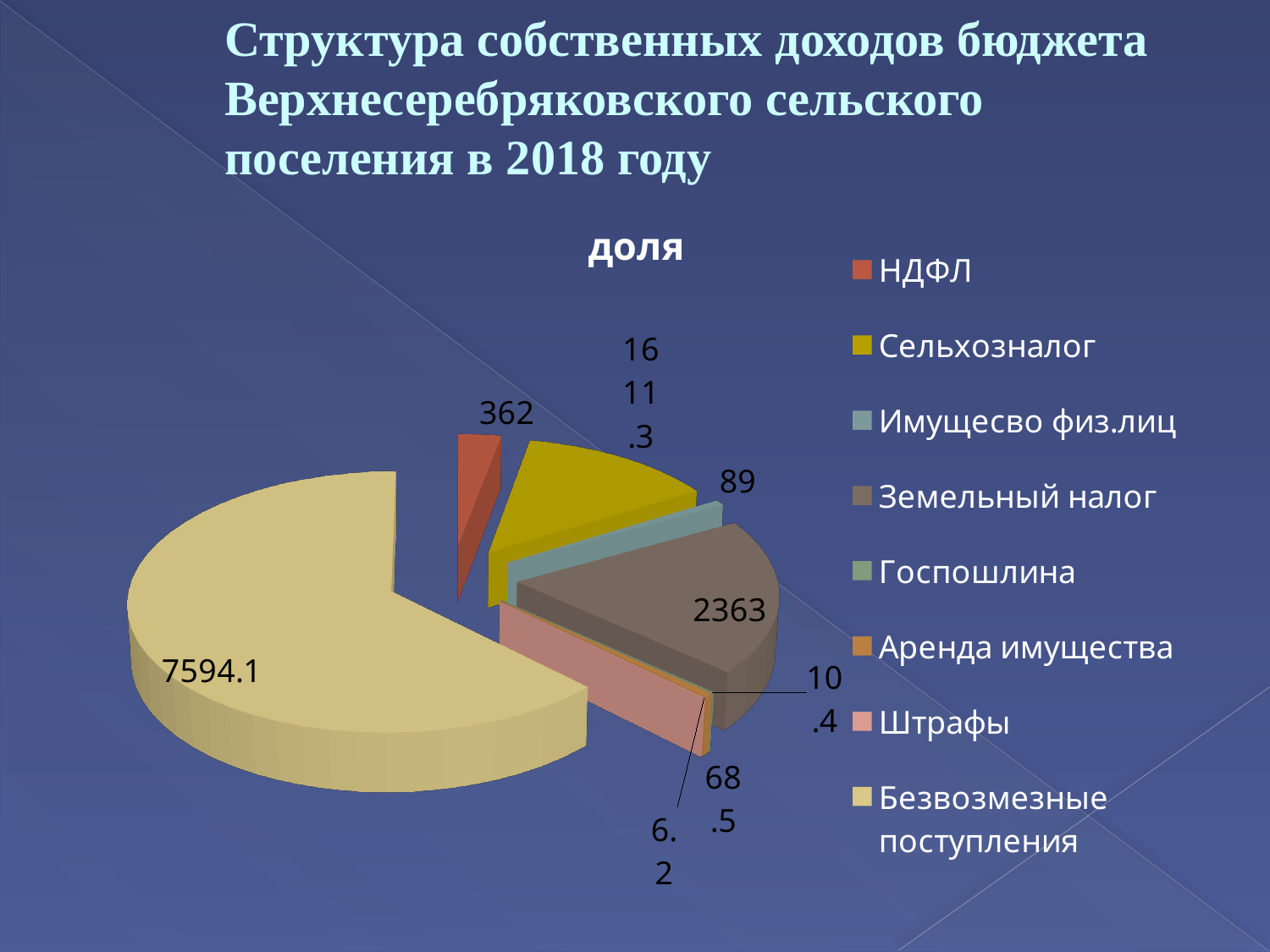
What is the value for Безвозмезные поступления? 7594.1 Which category has the largest slice of the pie? Безвозмезные поступления What is the difference between the values for Земельный налог and НДФЛ? 2001 What is the title of the pie chart? доля What colour is the slice for НДФЛ? red What is the value for Земельный налог? 2363 Which category has the smallest slice of the pie? Штрафы What kind of chart is shown on the slide? pie chart What is the value for НДФЛ? 362 Which is larger, the value for Сельхозналог or the value for Земельный налог? Земельный налог How many entries does the legend of the pie chart list? 8 What is the value for Имущесво физ.лиц? 89